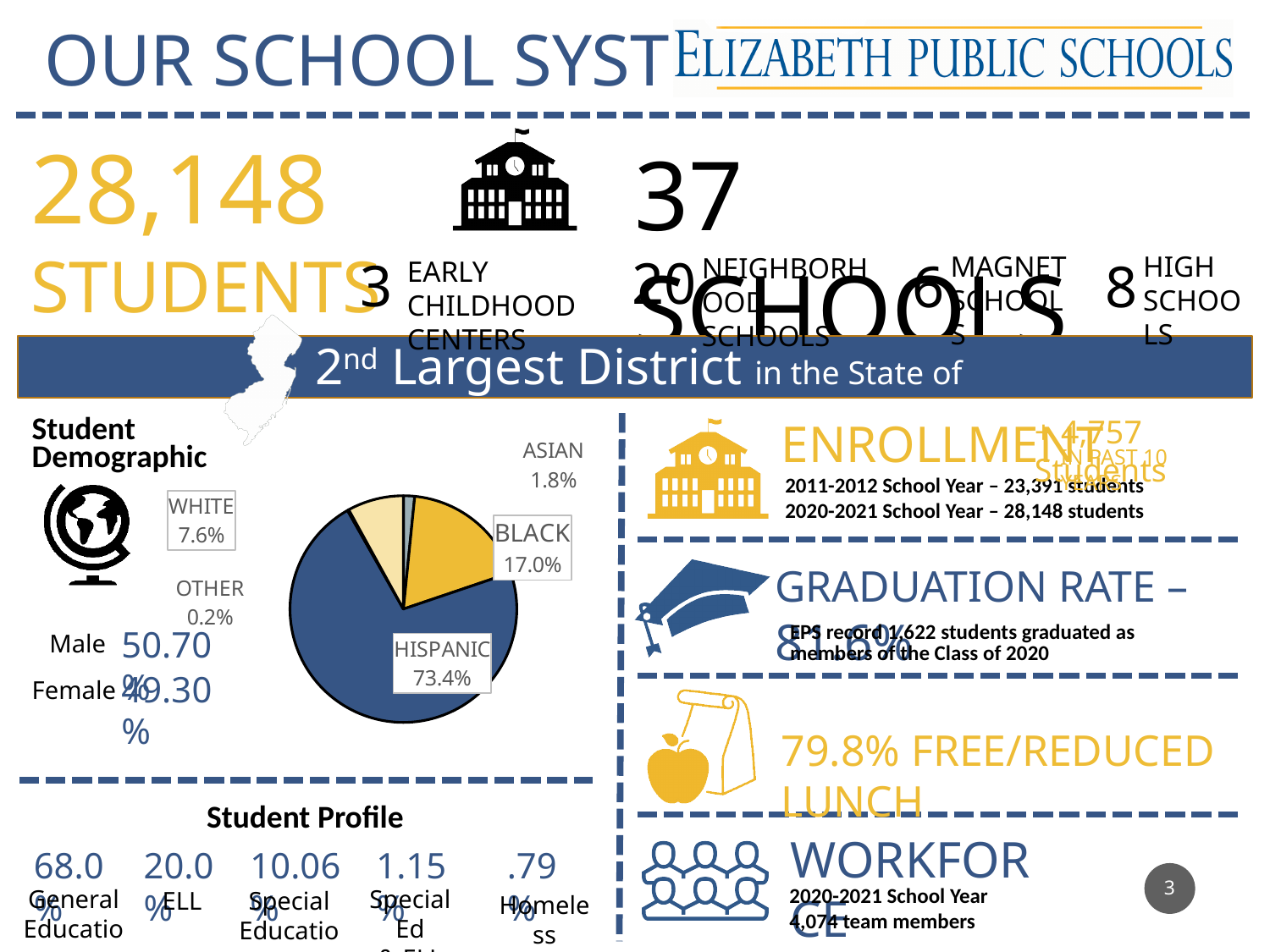
In the Student Demographic pie chart, what is the combined share of the BLACK and WHITE slices? 24.6% In the Student Demographic pie chart, which is larger, the WHITE slice or the ASIAN slice? WHITE In the Student Demographic pie chart, what is the difference in percentage points between the HISPANIC and BLACK slices? 56.4 What kind of chart is used for the Student Demographic data? pie chart How many slices does the Student Demographic pie chart have? 5 In the Student Demographic pie chart, what share is labelled for ASIAN? 1.8% Which slice of the Student Demographic pie chart is the largest? HISPANIC Which slice of the Student Demographic pie chart is the smallest? OTHER In the Student Demographic pie chart, what share is labelled for WHITE? 7.6% In the Student Demographic pie chart, what share is labelled for OTHER? 0.2% In the Student Demographic pie chart, what share is labelled for HISPANIC? 73.4% In the Student Demographic pie chart, what share is labelled for BLACK? 17.0%